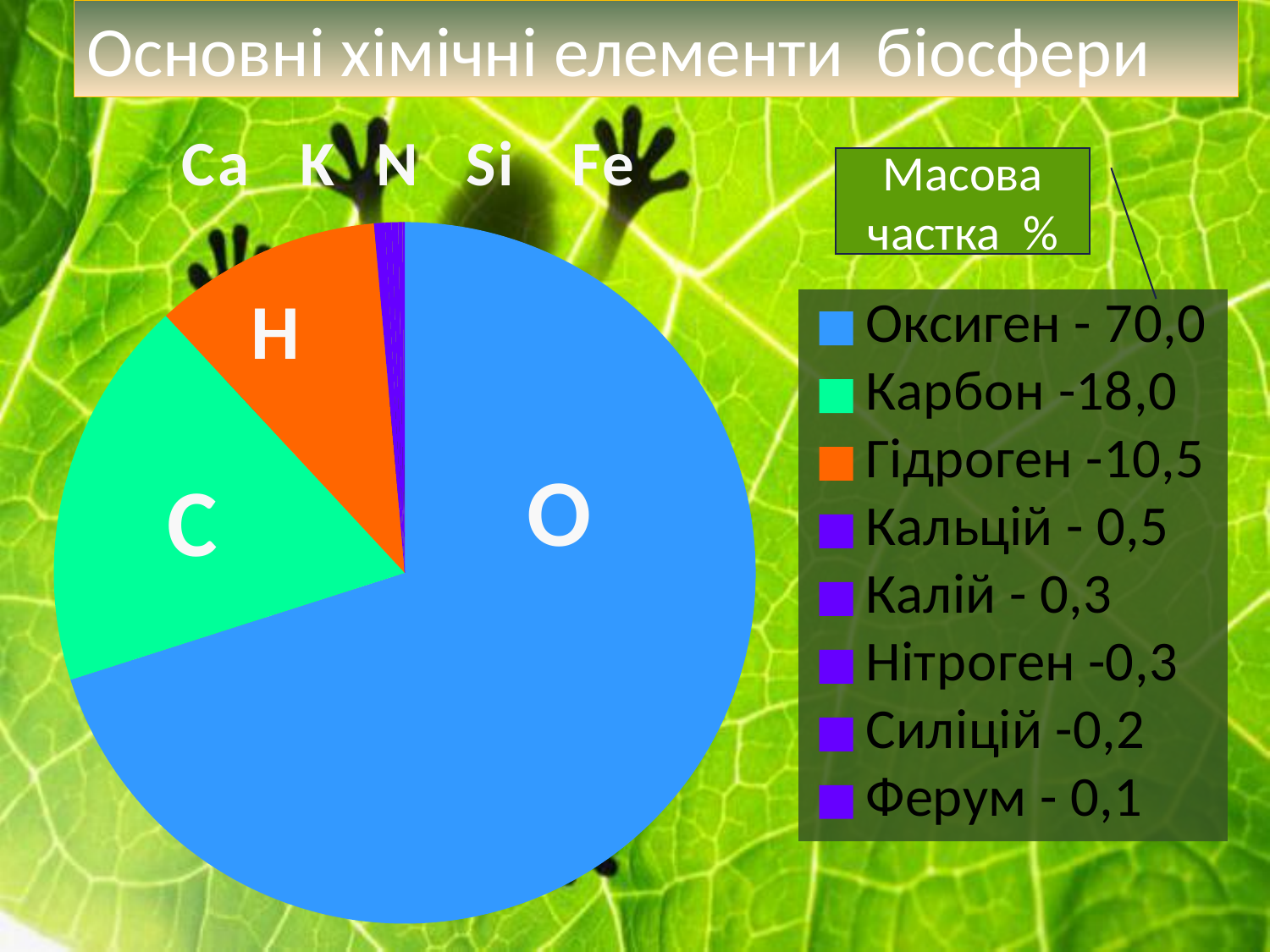
What is the difference between the mass shares of Оксиген and Карбон? 52,0 Which has a larger mass share, Карбон or Гідроген? Карбон What kind of chart is shown on the slide? pie chart What is the title of the slide? Основні хімічні елементи біосфери Which element has the smallest mass share in the legend? Ферум How many elements are listed in the legend? 8 What is the mass share of Карбон according to the legend? 18,0 What is the mass share of Оксиген according to the legend? 70,0 Which element has the largest slice of the pie? Оксиген What is the mass share of Ферум according to the legend? 0,1 What colour is the slice for Гідроген? orange What is the mass share of Гідроген according to the legend? 10,5